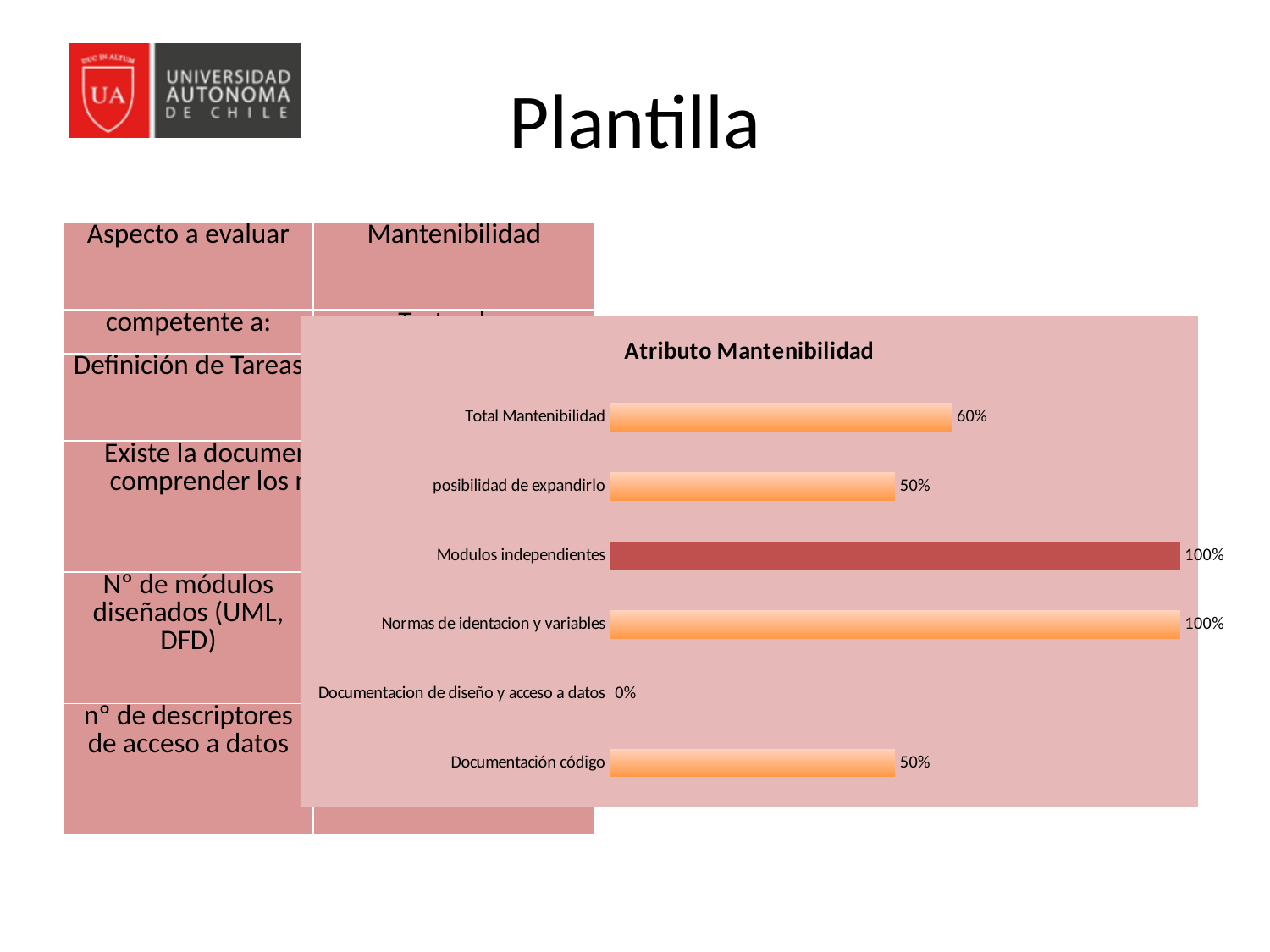
What is the value for Modulos independientes? 100% Which bar is shown in a different (dark red) colour from the others? Modulos independientes What is the title of the chart? Atributo Mantenibilidad What is the value for Documentación código? 50% How many categories are shown in the chart? 6 What is the value for posibilidad de expandirlo? 50% Which category has the lowest value in the chart? Documentacion de diseño y acceso a datos Which is larger, the value for Total Mantenibilidad or the value for posibilidad de expandirlo? Total Mantenibilidad What is the difference between the values for Modulos independientes and Total Mantenibilidad? 40% What is the value for Total Mantenibilidad in the Atributo Mantenibilidad chart? 60% What is the value for Documentacion de diseño y acceso a datos? 0% What kind of chart is shown on the slide? Bar chart